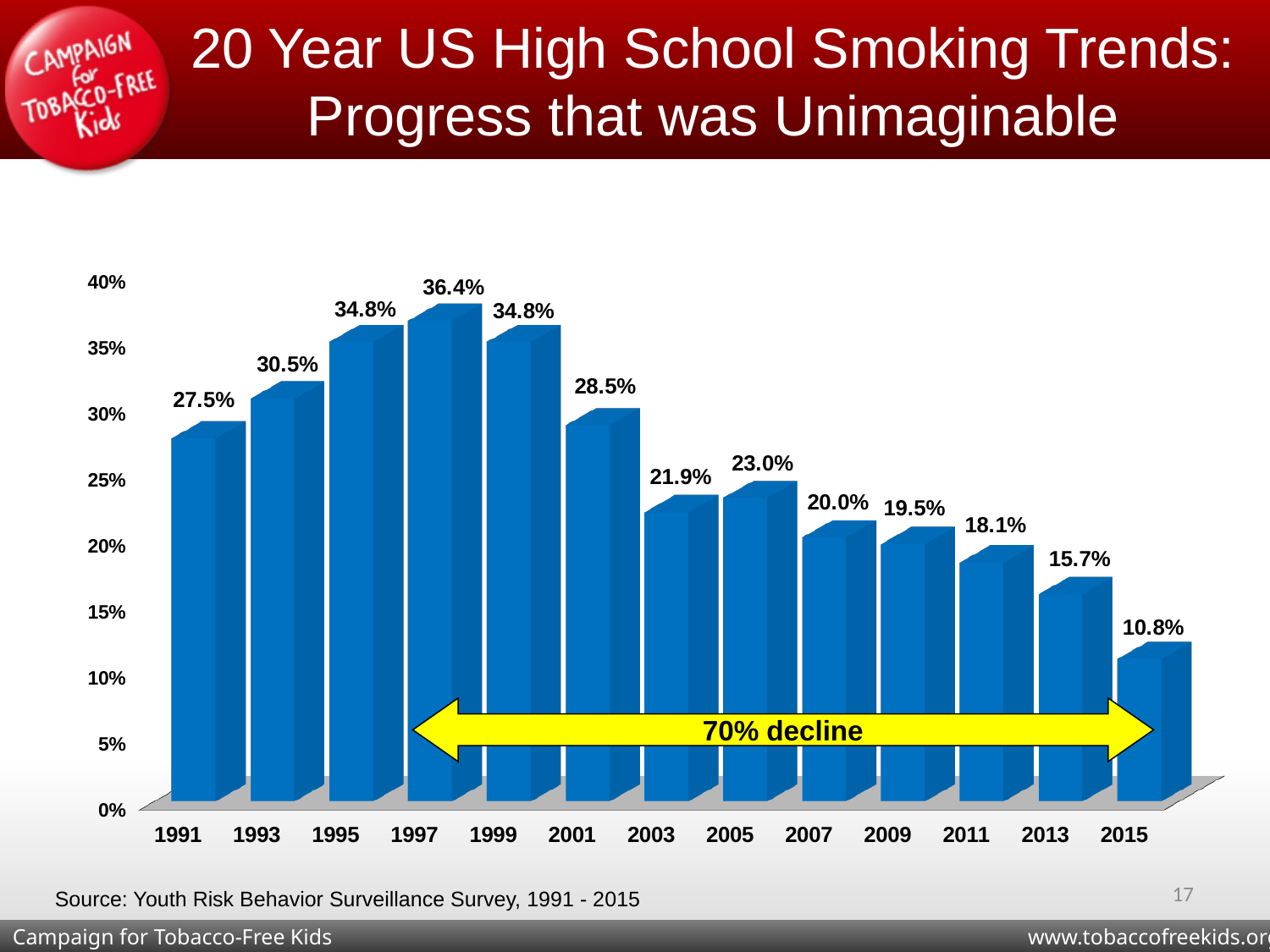
What was the US high school smoking rate in 2015? 10.8% Which year has the highest smoking rate on the chart? 1997 Which year has the lowest smoking rate on the chart? 2015 Which year had a higher smoking rate, 2003 or 2005? 2005 What was the US high school smoking rate in 1997? 36.4% What is the difference in smoking rate between 1997 and 2015? 25.6% What percentage decline does the yellow arrow on the chart indicate? 70% decline What is the difference in smoking rate between 1991 and 1993? 3.0% What kind of chart is shown on the slide? Bar chart Is the smoking rate for 2001 greater or less than 25%? greater How many years are shown on the x axis of the chart? 13 What was the US high school smoking rate in 2005? 23.0%